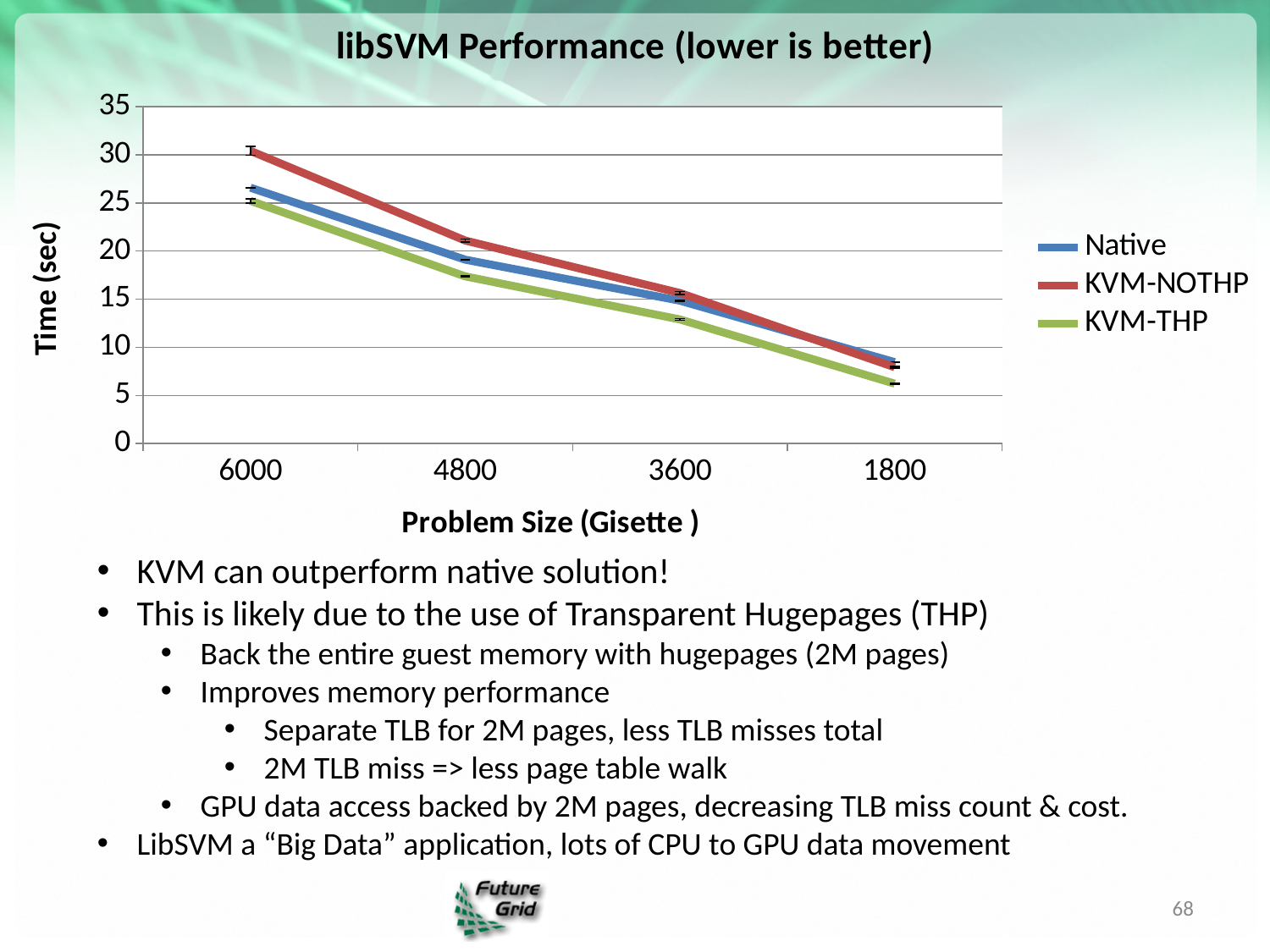
Which series has the lowest time at problem size 6000? KVM-THP Is the value for KVM-THP at problem size 1800 greater or less than 10? less What kind of chart is shown on the slide? line chart Is the value for KVM-NOTHP at problem size 6000 greater or less than 25? greater Do the KVM-THP values rise or fall moving from left to right along the x axis? fall What is the title of the y axis? Time (sec) At problem size 4800, which is larger: the value for Native or the value for KVM-THP? Native Is the value for Native at problem size 4800 greater or less than 15? greater Which series has the highest time at problem size 6000? KVM-NOTHP Which series has the lowest time at problem size 1800? KVM-THP How many problem sizes are plotted along the x axis? 4 How many series does the legend list? 3